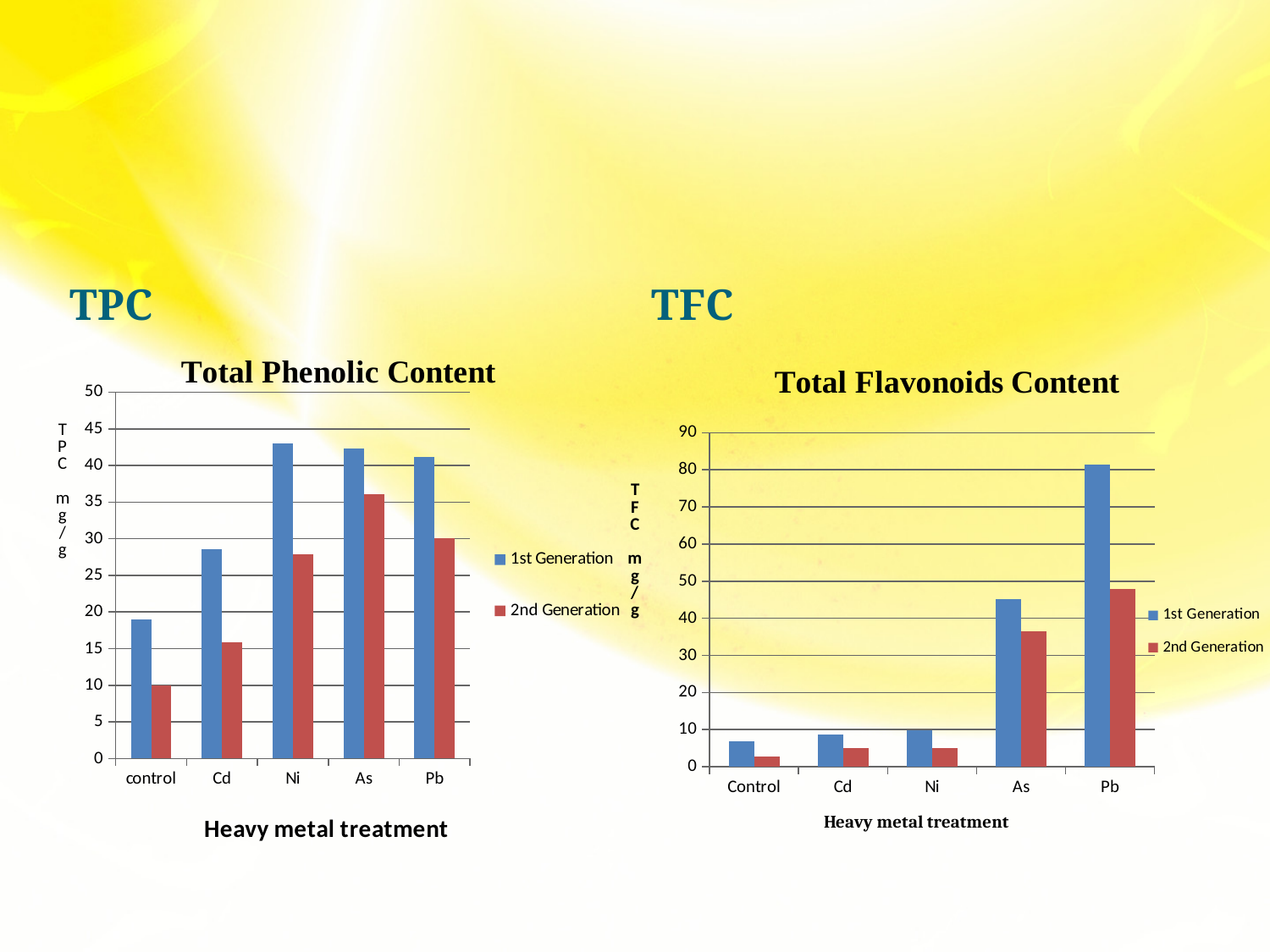
How many heavy metal treatment categories are shown on the Total Flavonoids Content chart? 5 What is the x-axis title of the Total Phenolic Content chart? Heavy metal treatment What type of chart is the Total Phenolic Content chart? bar chart In the Total Phenolic Content chart, which treatment has the highest 2nd Generation value? As In the Total Flavonoids Content chart, which treatment has the lowest 1st Generation value? Control How many series does the legend of the Total Phenolic Content chart list? 2 In the Total Flavonoids Content chart, which is larger for Pb: the 1st Generation value or the 2nd Generation value? 1st Generation In the Total Flavonoids Content chart, is the 1st Generation value for Pb greater or less than 70? greater In the Total Flavonoids Content chart, is the 2nd Generation value for As greater or less than 40? less In the Total Phenolic Content chart, is the 1st Generation value for Ni greater or less than 40? greater In the Total Flavonoids Content chart, which treatment has the highest 1st Generation value? Pb In the Total Phenolic Content chart, which treatment has the lowest 1st Generation value? control